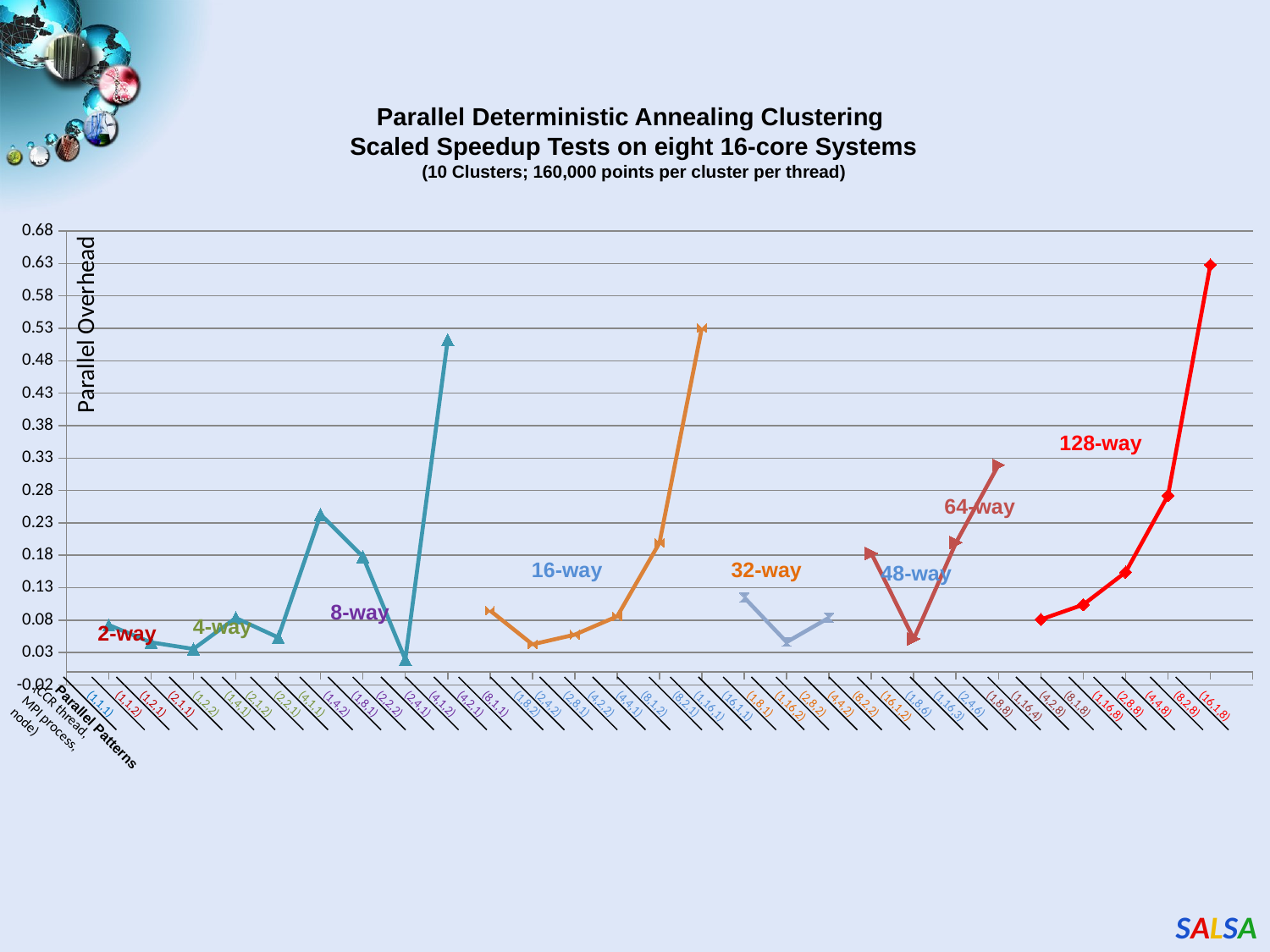
Which series reaches the highest Parallel Overhead on the chart? 128-way Does the Parallel Overhead of the 128-way series rise or fall from left to right along the x axis? rise Which has the larger peak Parallel Overhead, the 128-way series or the 32-way series? 128-way Is the highest value of the 32-way series greater or less than 0.48? greater Is the highest value of the 64-way series greater or less than 0.28? greater What kind of chart is shown on the slide? line chart Is the highest value of the 16-way series greater or less than 0.43? greater What is the title of the chart on the slide? Parallel Deterministic Annealing Clustering Scaled Speedup Tests on eight 16-core Systems What is the label on the vertical axis of the chart? Parallel Overhead How many '-way' series are labelled on the chart? 8